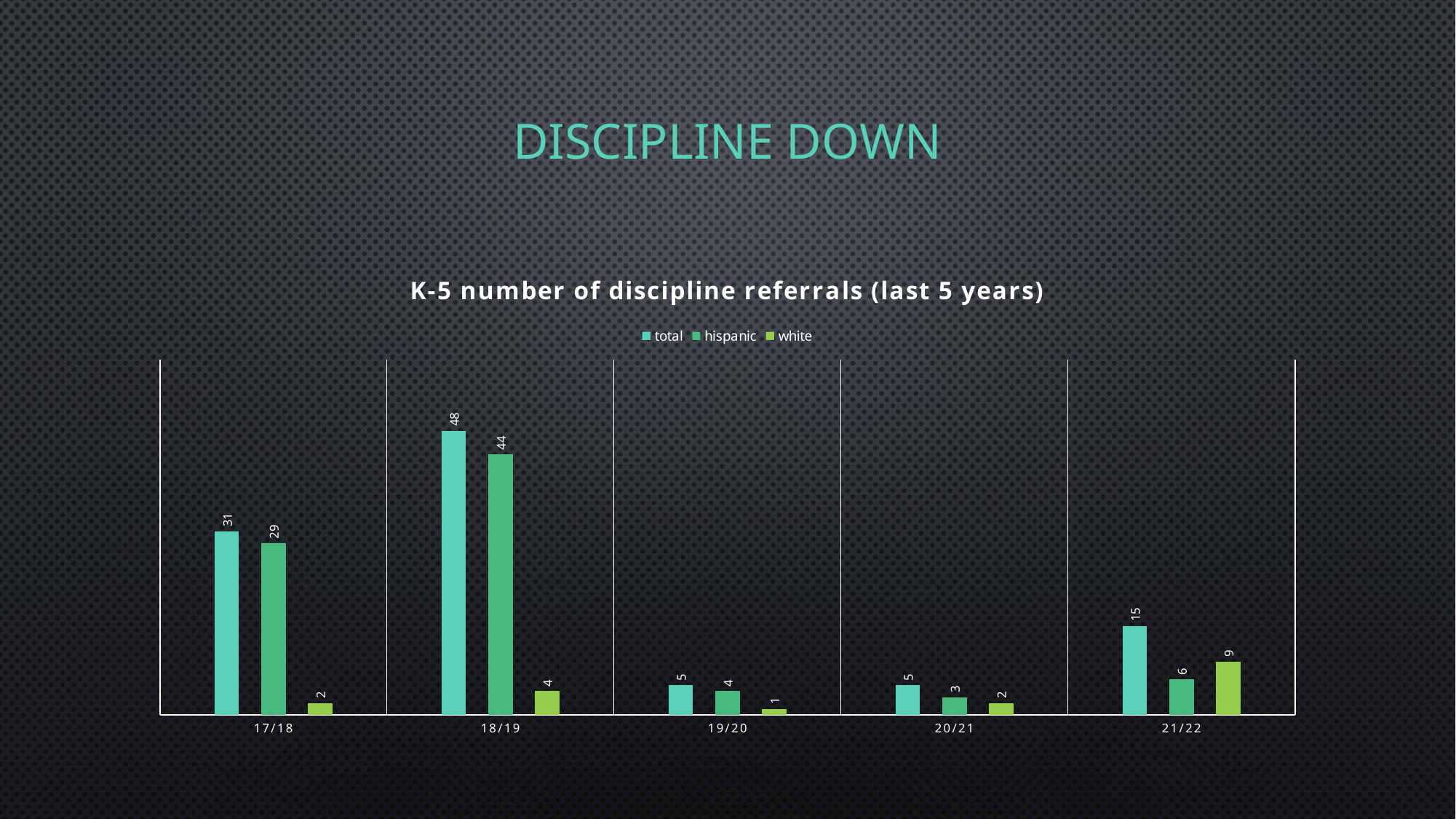
How many years are shown on the x axis? 5 What is the value for white in 21/22? 9 Which year has the highest total number of discipline referrals? 18/19 What is the value for hispanic in 17/18? 29 How many series does the legend list? 3 What is the difference between the total values for 18/19 and 21/22? 33 Which year has the lowest value for white? 19/20 What kind of chart is shown on the slide? bar chart What is the title of the chart? K-5 number of discipline referrals (last 5 years) Which is larger in 21/22, the hispanic value or the white value? white What is the total number of discipline referrals in 18/19? 48 Does the total number of referrals rise or fall from 18/19 to 20/21? fall